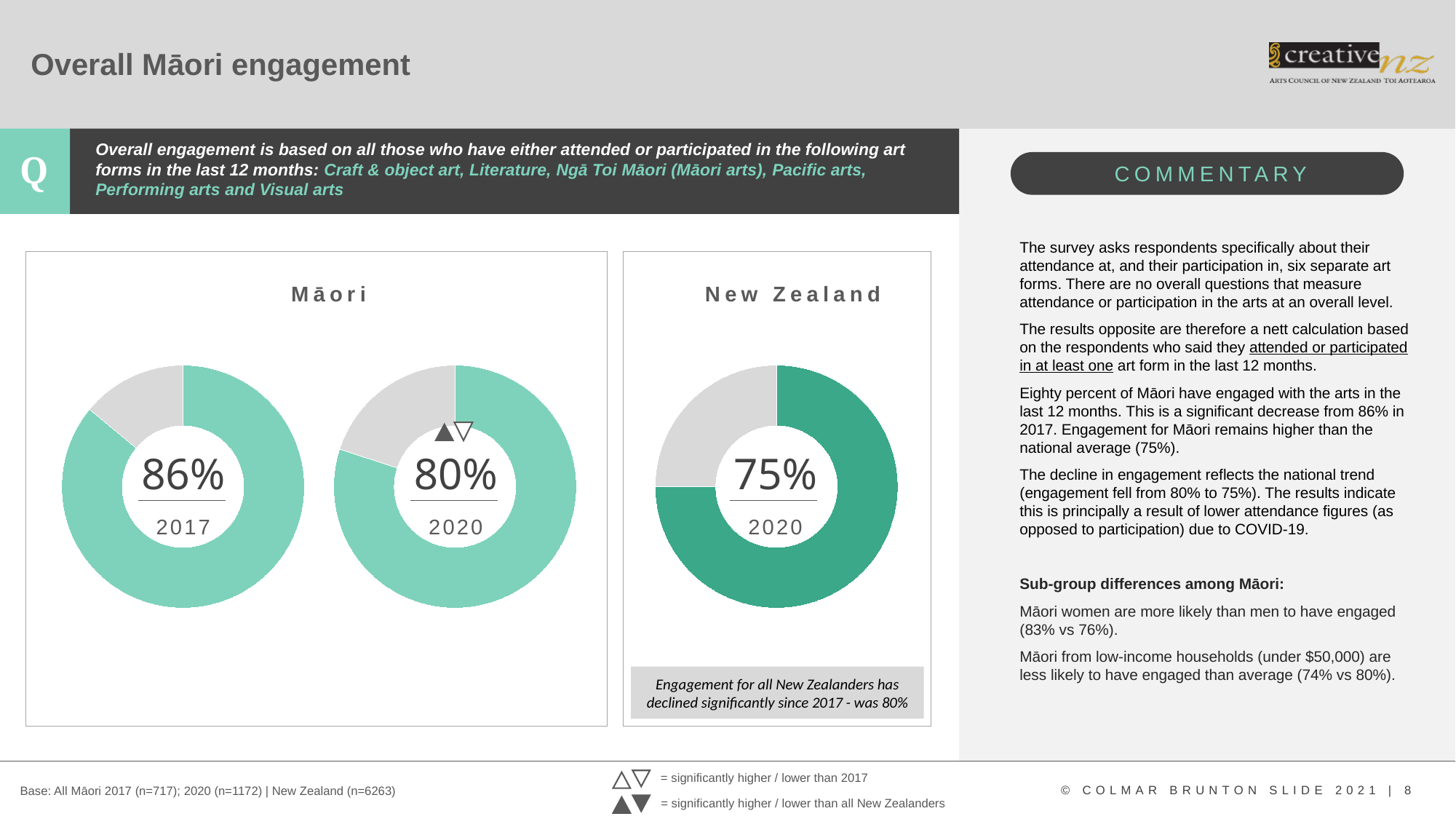
In the Māori chart, does engagement rise or fall from 2017 to 2020? Fall In the New Zealand chart, what is the engagement value shown for 2020? 75% In the Māori chart, what is the engagement value shown for 2017? 86% In the Māori chart, what is the engagement value shown for 2020? 80% What kind of chart is used to show the engagement values on this slide? Donut (pie) chart Which of the three donut charts shows the lowest value? New Zealand 2020 How many donut charts are shown on the slide? 3 What is the title of the chart on the right-hand side of the chart area? New Zealand Which of the three donut charts shows the highest value? Māori 2017 In the Māori chart, by how many percentage points did engagement change from 2017 to 2020? 6 percentage points Which is larger: the Māori 2020 value or the New Zealand 2020 value? Māori 2020 What is the difference between the Māori 2020 value and the New Zealand 2020 value? 5 percentage points